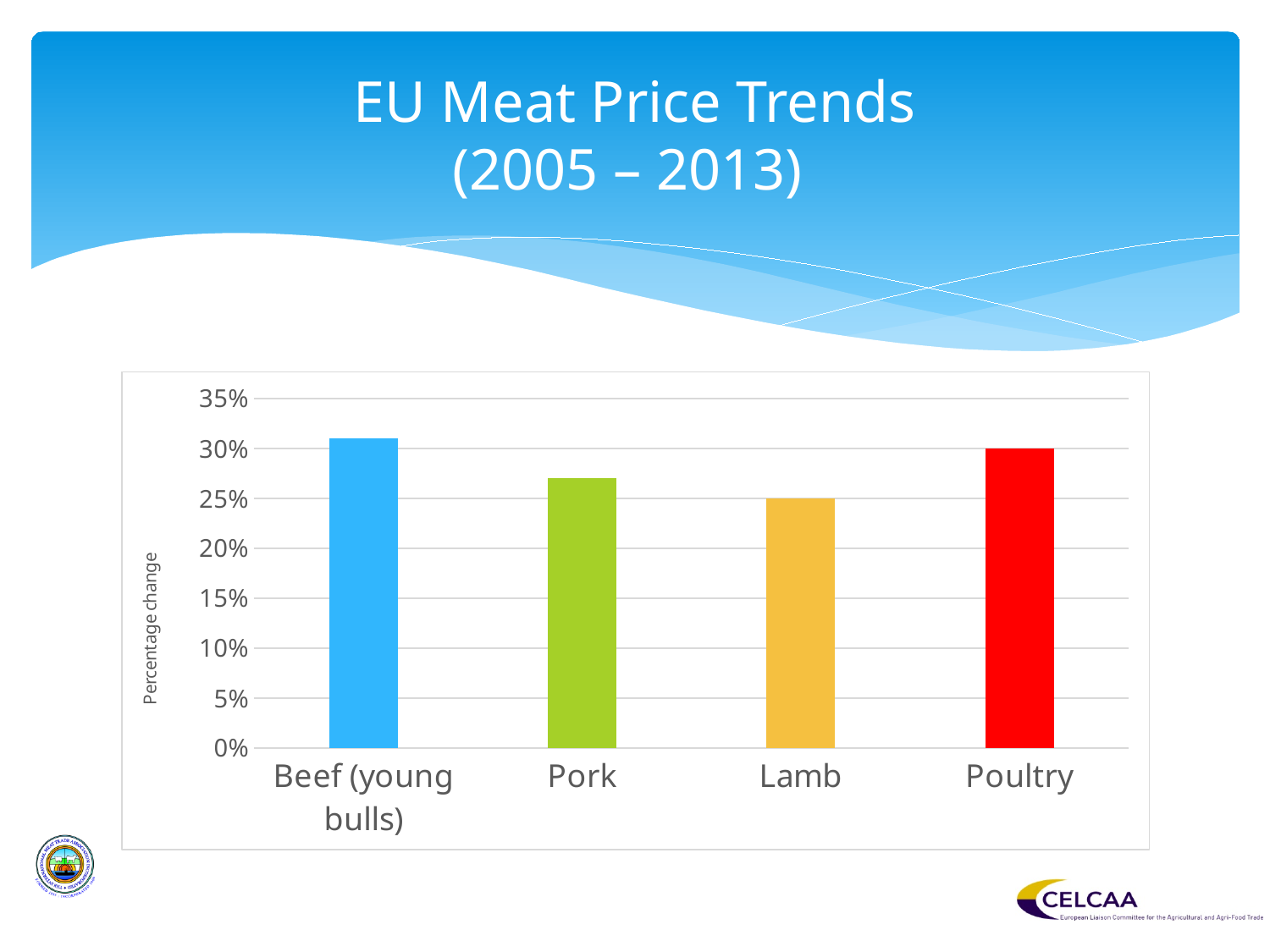
Is the value for Pork greater or less than 30%? less Which category has the highest percentage change? Beef (young bulls) What is the difference between the percentage change for Poultry and for Lamb? 5% Which has a larger percentage change, Pork or Lamb? Pork What is the percentage change for Poultry? 30% What is the percentage change for Lamb? 25% What kind of chart is shown on the slide? bar chart Which category has the lowest percentage change? Lamb How many meat categories are plotted in the chart? 4 Is the value for Beef (young bulls) greater or less than 30%? greater Is the value for Pork greater or less than 25%? greater What is the label on the vertical axis of the chart? Percentage change